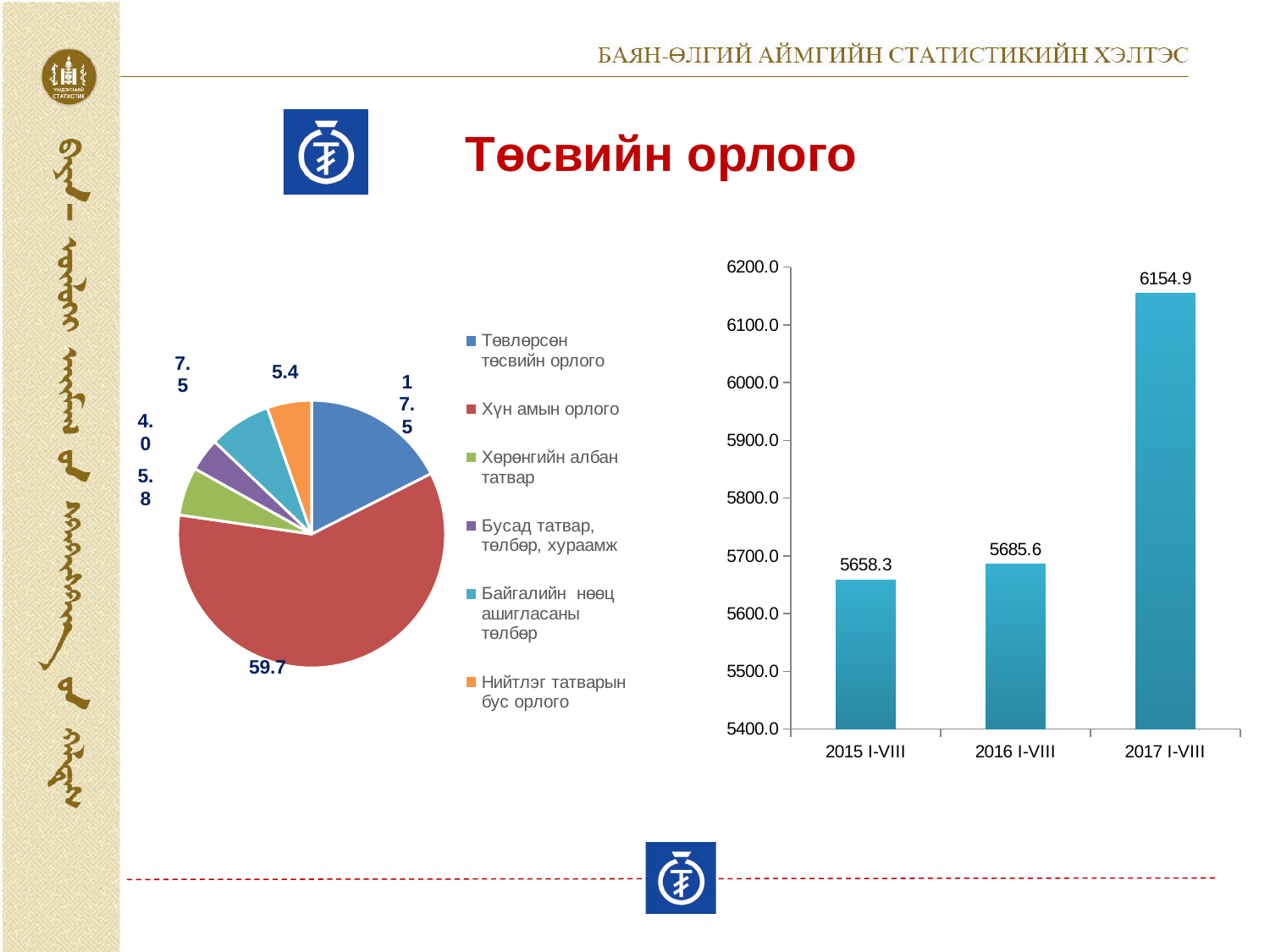
On the bar chart on the right, what is the value for 2015 I-VIII? 5658.3 On the pie chart on the left, what is the value for Хүн амын орлого? 59.7 On the pie chart on the left, what is the value for Төвлөрсөн төсвийн орлого? 17.5 What kind of chart is on the right side of the slide? bar chart On the bar chart on the right, what is the difference between the values for 2017 I-VIII and 2016 I-VIII? 469.3 On the bar chart on the right, what is the value for 2017 I-VIII? 6154.9 On the pie chart on the left, how many categories does the legend list? 6 On the bar chart on the right, do the values rise or fall from 2015 I-VIII to 2017 I-VIII? rise On the pie chart on the left, which category has the smallest slice? Бусад татвар, төлбөр, хураамж On the bar chart on the right, which period has the lowest value? 2015 I-VIII On the bar chart on the right, which period has the highest value? 2017 I-VIII On the bar chart on the right, how many periods are shown on the x axis? 3